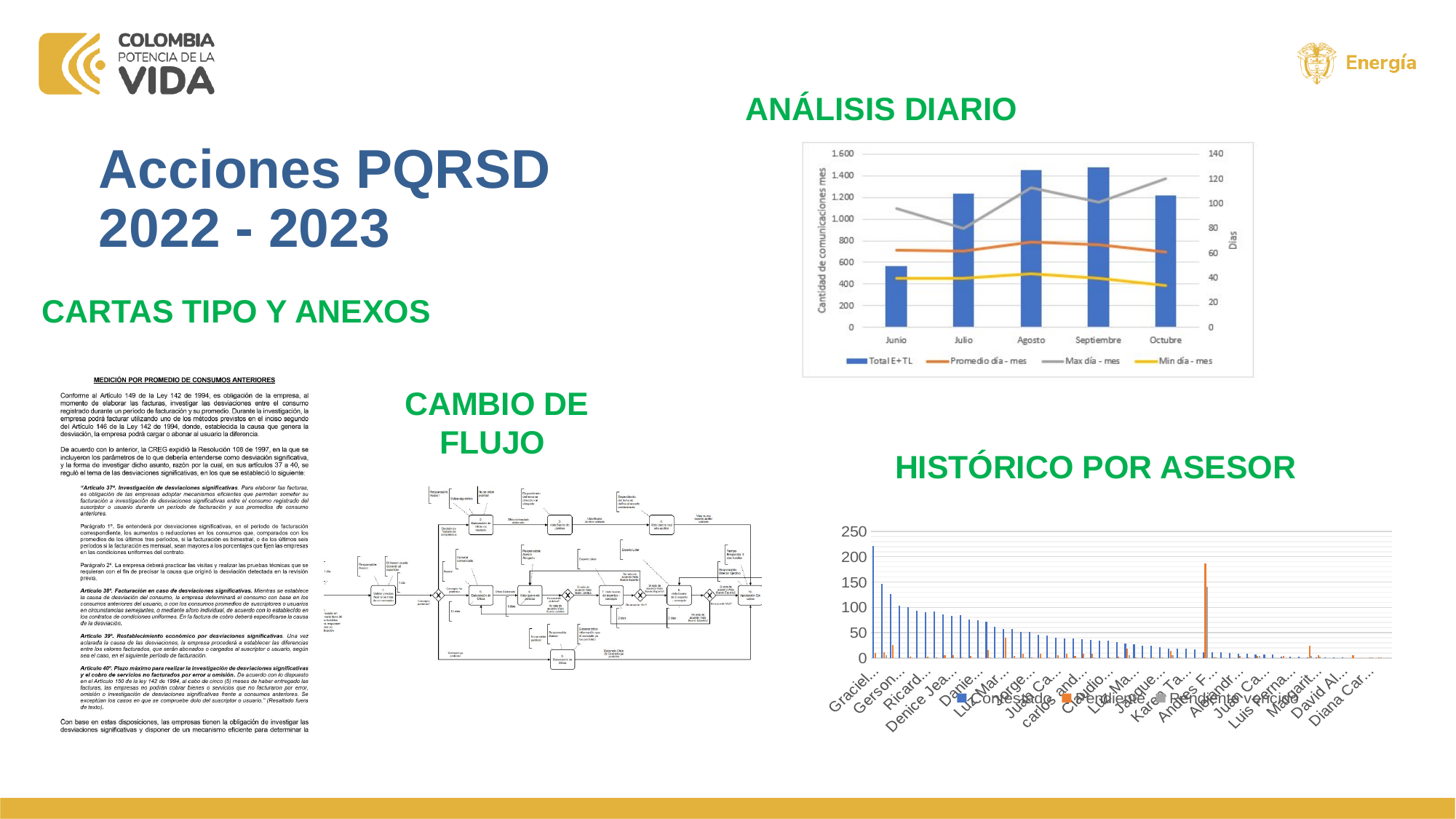
In the ANÁLISIS DIARIO chart, how many series does the legend list? 4 In the ANÁLISIS DIARIO chart, which month has the lowest Total E+TL bar? Junio In the ANÁLISIS DIARIO chart, what is the title of the left vertical axis? Cantidad de comunicaciones mes In the ANÁLISIS DIARIO chart, does the Total E+TL bar rise or fall from Junio to Agosto? rise In the ANÁLISIS DIARIO chart, how many months are shown on the x axis? 5 In the ANÁLISIS DIARIO chart, is the Total E+TL value for Julio greater or less than 1.000? greater In the HISTÓRICO POR ASESOR chart, how many series does the legend list? 3 In the ANÁLISIS DIARIO chart, which has the larger Total E+TL bar, Junio or Julio? Julio In the ANÁLISIS DIARIO chart, is the Total E+TL value for Agosto greater or less than 1.200? greater In the ANÁLISIS DIARIO chart, in which month does the Max día - mes line reach its highest point? Octubre What kind of chart is the HISTÓRICO POR ASESOR chart? bar chart In the ANÁLISIS DIARIO chart, is the Total E+TL value for Junio greater or less than 800? less